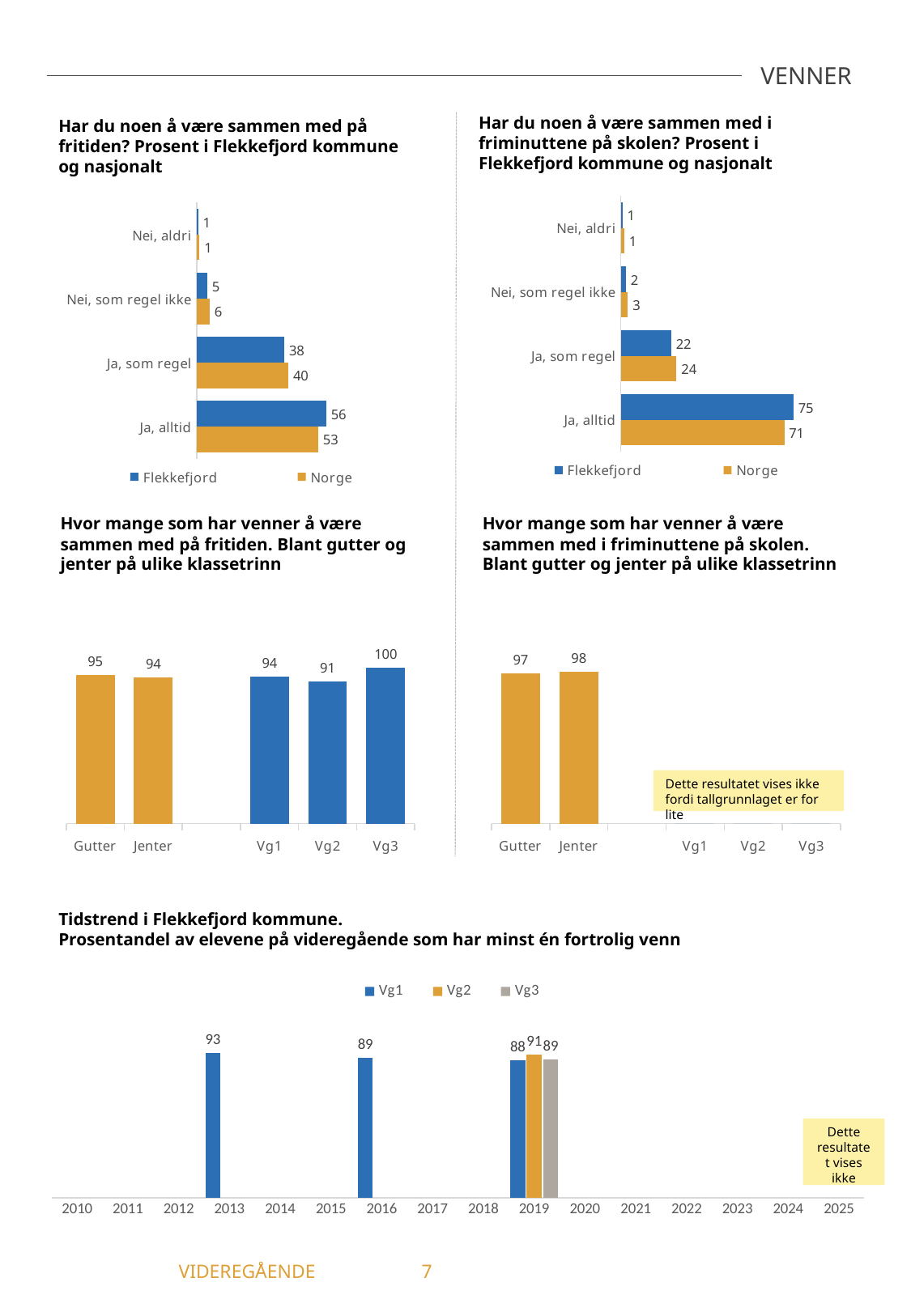
In the top-right chart 'Har du noen å være sammen med i friminuttene på skolen?', which category has the highest Flekkefjord value? Ja, alltid In the middle-left chart 'Hvor mange som har venner å være sammen med på fritiden', what is the value for Vg3? 100 In the top-right chart 'Har du noen å være sammen med i friminuttene på skolen?', is the Flekkefjord value for 'Ja, som regel' larger or smaller than the Norge value? smaller In the top-left chart 'Har du noen å være sammen med på fritiden?', what is the difference between the Norge and Flekkefjord values for 'Ja, som regel'? 2 In the middle-left chart 'Hvor mange som har venner å være sammen med på fritiden', which category has the lowest value? Vg2 In the top-right chart 'Har du noen å være sammen med i friminuttene på skolen?', what is the Norge value for 'Ja, alltid'? 71 In the top-left chart 'Har du noen å være sammen med på fritiden?', what is the Flekkefjord value for 'Ja, alltid'? 56 In the middle-right chart 'Hvor mange som har venner å være sammen med i friminuttene på skolen', what is the value for Jenter? 98 In the bottom chart 'Tidstrend i Flekkefjord kommune', what is the difference between the Vg1 values for 2013 and 2016? 4 In the bottom chart 'Tidstrend i Flekkefjord kommune', what is the Vg2 value for 2019? 91 How many series does the legend list in the top-left chart 'Har du noen å være sammen med på fritiden?'? 2 What kind of chart is the bottom chart 'Tidstrend i Flekkefjord kommune'? bar chart